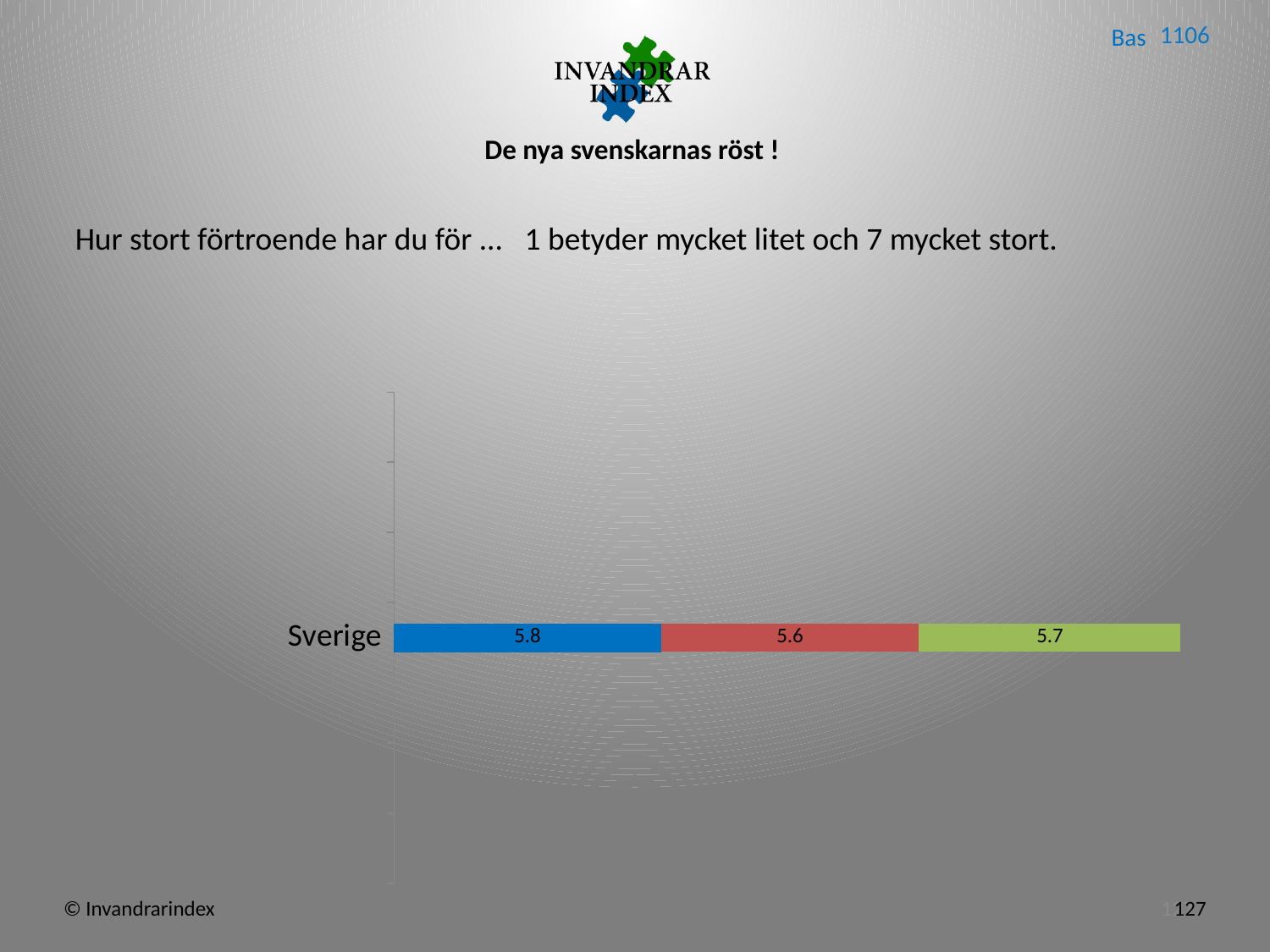
How many categories are shown on the chart? 1 What value is shown on the red segment of the Sverige bar? 5.6 What is the name of the only category shown on the chart? Sverige What kind of chart is shown on the slide? stacked horizontal bar chart What is the difference between the blue segment value and the red segment value in the Sverige bar? 0.2 What is the total of the three segments in the Sverige bar? 17.1 What value is shown on the blue segment of the Sverige bar? 5.8 What value is shown on the green segment of the Sverige bar? 5.7 Which segment of the Sverige bar has the lowest value? the red segment (5.6) Which segment of the Sverige bar has the highest value? the blue segment (5.8) Which is larger in the Sverige bar, the green segment value or the red segment value? the green segment (5.7) How many segments make up the Sverige bar? 3